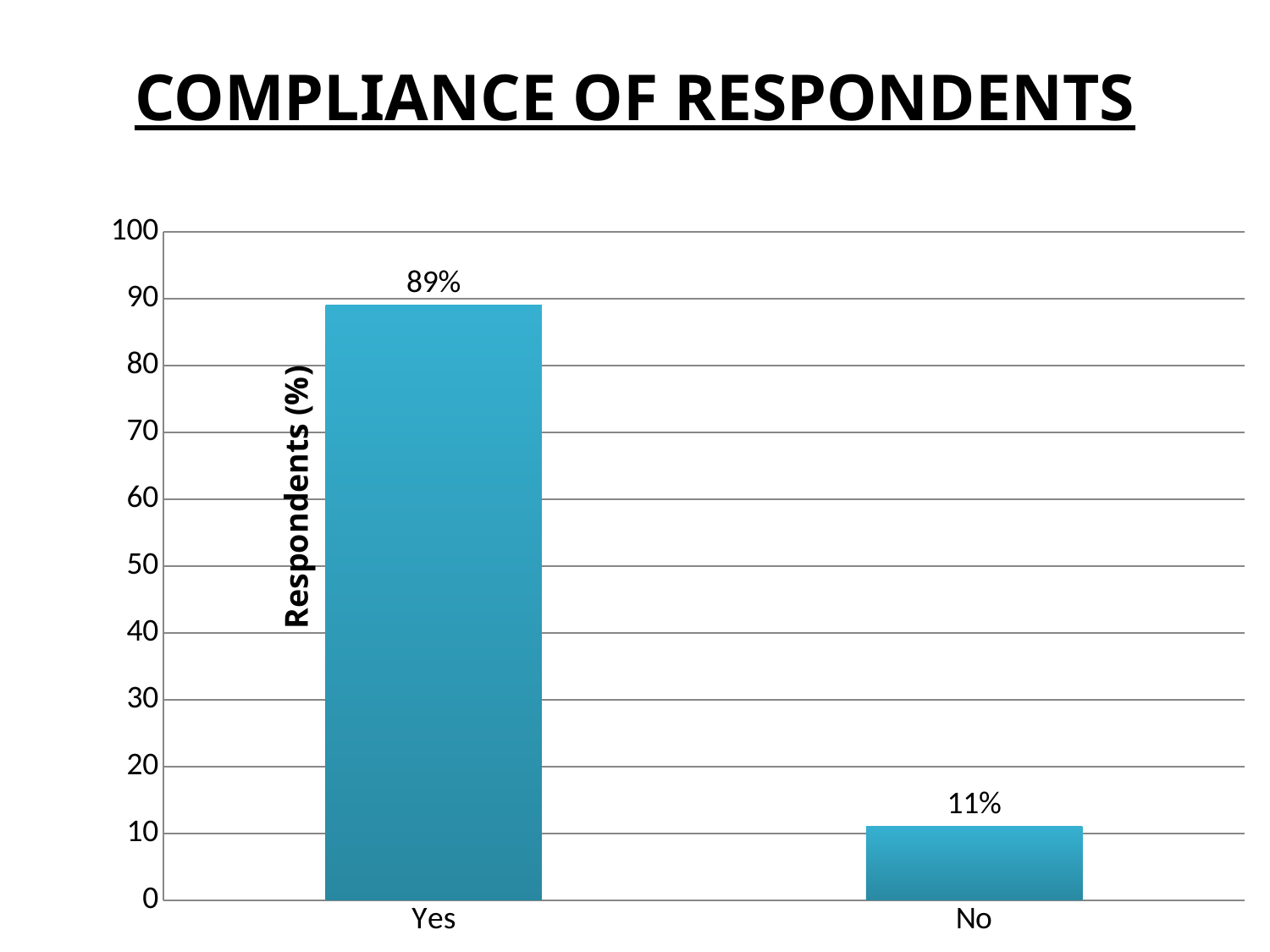
What kind of chart is shown on the slide? bar chart What is the difference between the values for Yes and No? 78% Which category has the lowest value? No What is the value for No? 11% Is the value for Yes greater or less than 80? greater What is the value for Yes? 89% What is the title of the slide? COMPLIANCE OF RESPONDENTS Is the value for No greater or less than 20? less Which is larger, the value for Yes or the value for No? Yes Which category has the highest value? Yes What is the label of the vertical axis? Respondents (%) How many categories are shown on the x axis? 2